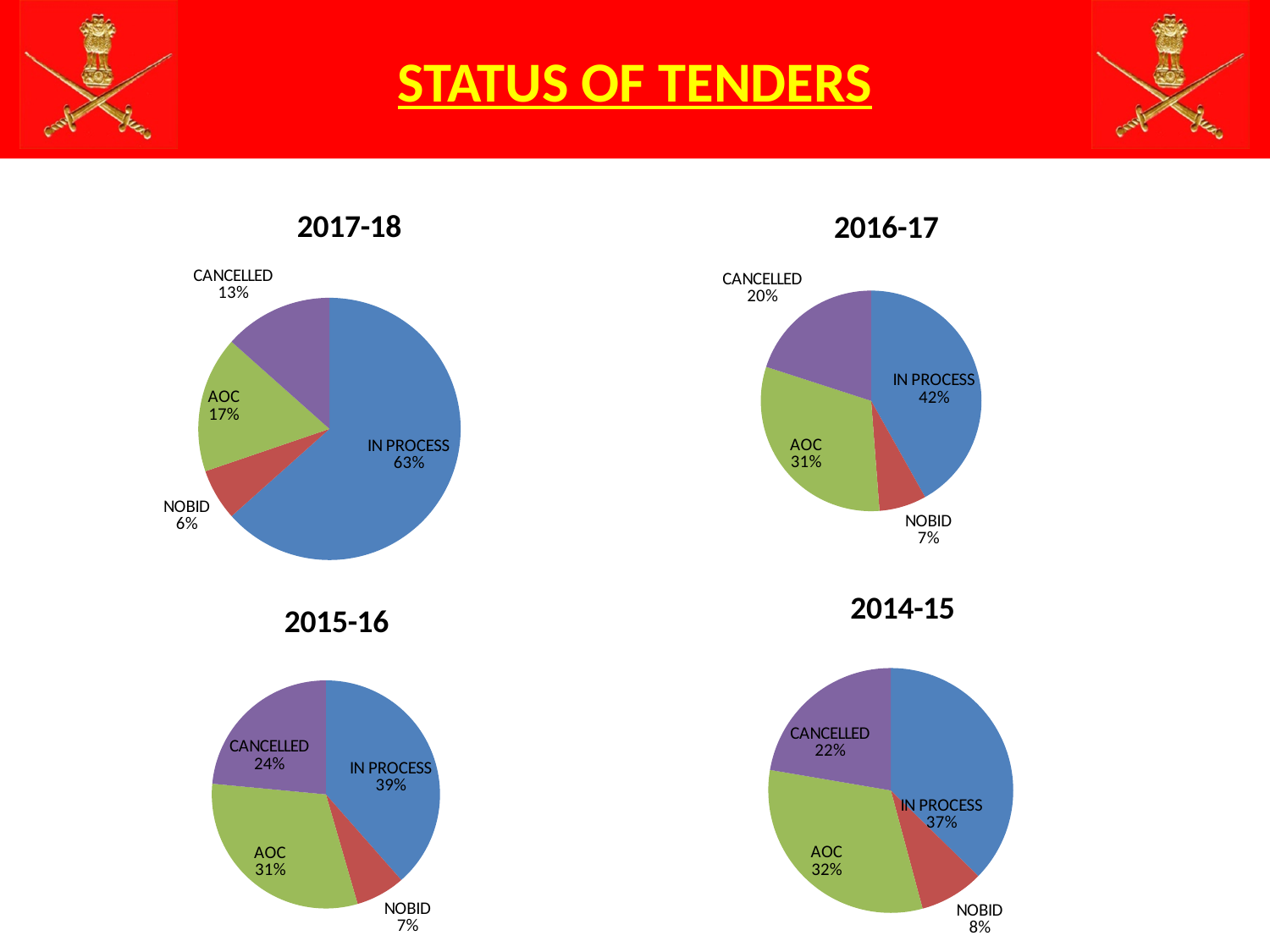
In the 2016-17 chart, what share of tenders is AOC? 31% In the 2015-16 chart, which is larger, the AOC slice or the CANCELLED slice? AOC In the 2015-16 chart, what share of tenders is CANCELLED? 24% In the 2017-18 chart, what share of tenders is IN PROCESS? 63% What is the title of the slide? STATUS OF TENDERS In the 2016-17 chart, which category has the smallest slice? NOBID In the 2017-18 chart, which category has the largest slice? IN PROCESS What type of chart is used for 2016-17? Pie chart How many pie charts are shown on the slide? 4 In the 2014-15 chart, what share of tenders is NOBID? 8% In the 2014-15 chart, what is the difference between the IN PROCESS and AOC shares? 5% How many slices does the 2017-18 pie chart have? 4